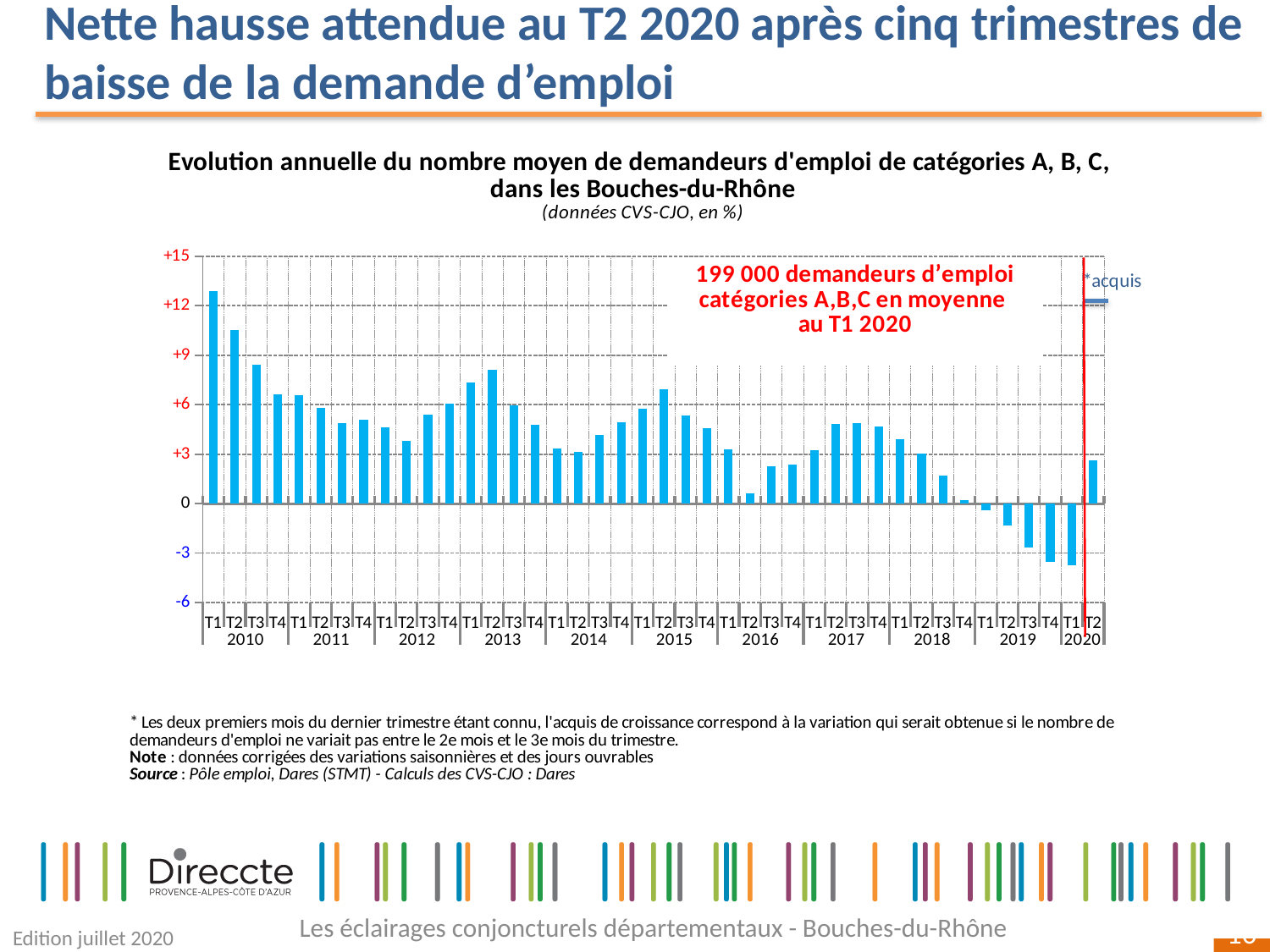
In what unit are the data in the chart expressed, according to the subtitle? % What kind of chart is shown on the slide? bar chart Is the value for T1 2010 greater or less than +12? greater How many quarterly bars are plotted in the chart, from T1 2010 to T2 2020? 42 Is the value for T1 2020 greater or less than -3? less Is the value for T2 2010 greater or less than +9? greater Do the values rise or fall from T1 2010 to T4 2010? fall Which is larger, the value for T2 2013 or the value for T2 2015? T2 2013 How many quarters in the chart have a negative value? 5 Which quarter has the highest value in the chart? T1 2010